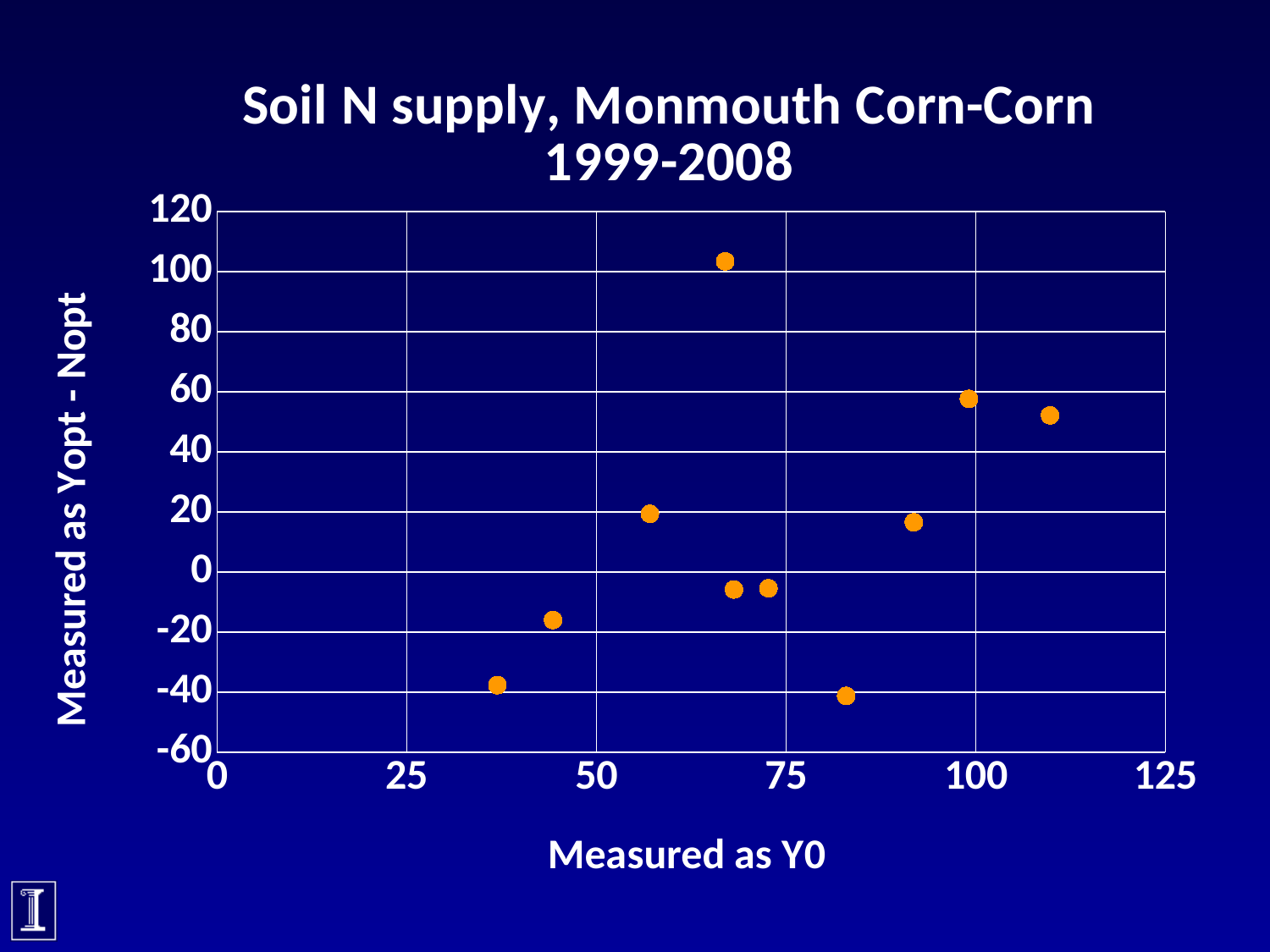
How many data points have a y value greater than 0? 5 Is the y value of the highest point on the chart greater or less than 100? greater What is the label of the x axis? Measured as Y0 What is the maximum value shown on the y axis? 120 Is the x value of the highest point on the chart greater or less than 75? less What is the title of the chart? Soil N supply, Monmouth Corn-Corn 1999-2008 Is the y value of the point with the largest x value (near x = 110) greater or less than 40? greater How many data points have a y value less than 0? 5 What kind of chart is shown on the slide? scatter chart How many data points are plotted on the chart? 10